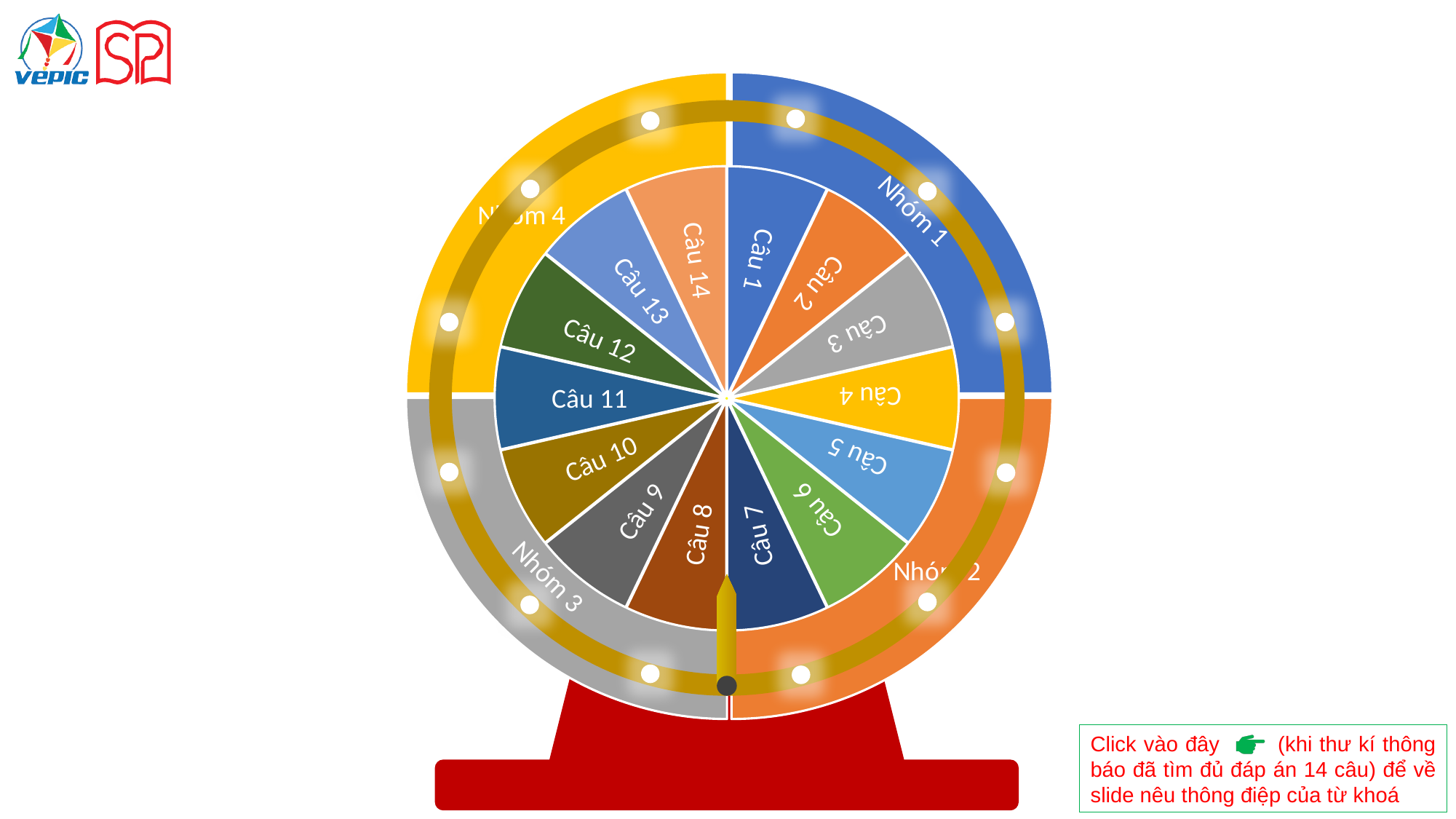
What is the lowest-numbered slice on the wheel? Câu 1 What kind of chart is the wheel built from? pie chart How many numbered slices (Câu) does the inner wheel have? 14 Which group label appears on the grey section of the outer ring at the bottom left? Nhóm 3 What is the label of the slice immediately counter-clockwise from Câu 1? Câu 14 Which group label appears on the yellow section of the outer ring at the top left? Nhóm 4 What is the highest-numbered slice on the wheel? Câu 14 Which group label appears on the orange section of the outer ring at the bottom right? Nhóm 2 Which group label appears on the blue section of the outer ring at the top right? Nhóm 1 How many groups (Nhóm) are labelled on the outer ring of the wheel? 4 What is the label of the slice immediately clockwise from Câu 1? Câu 2